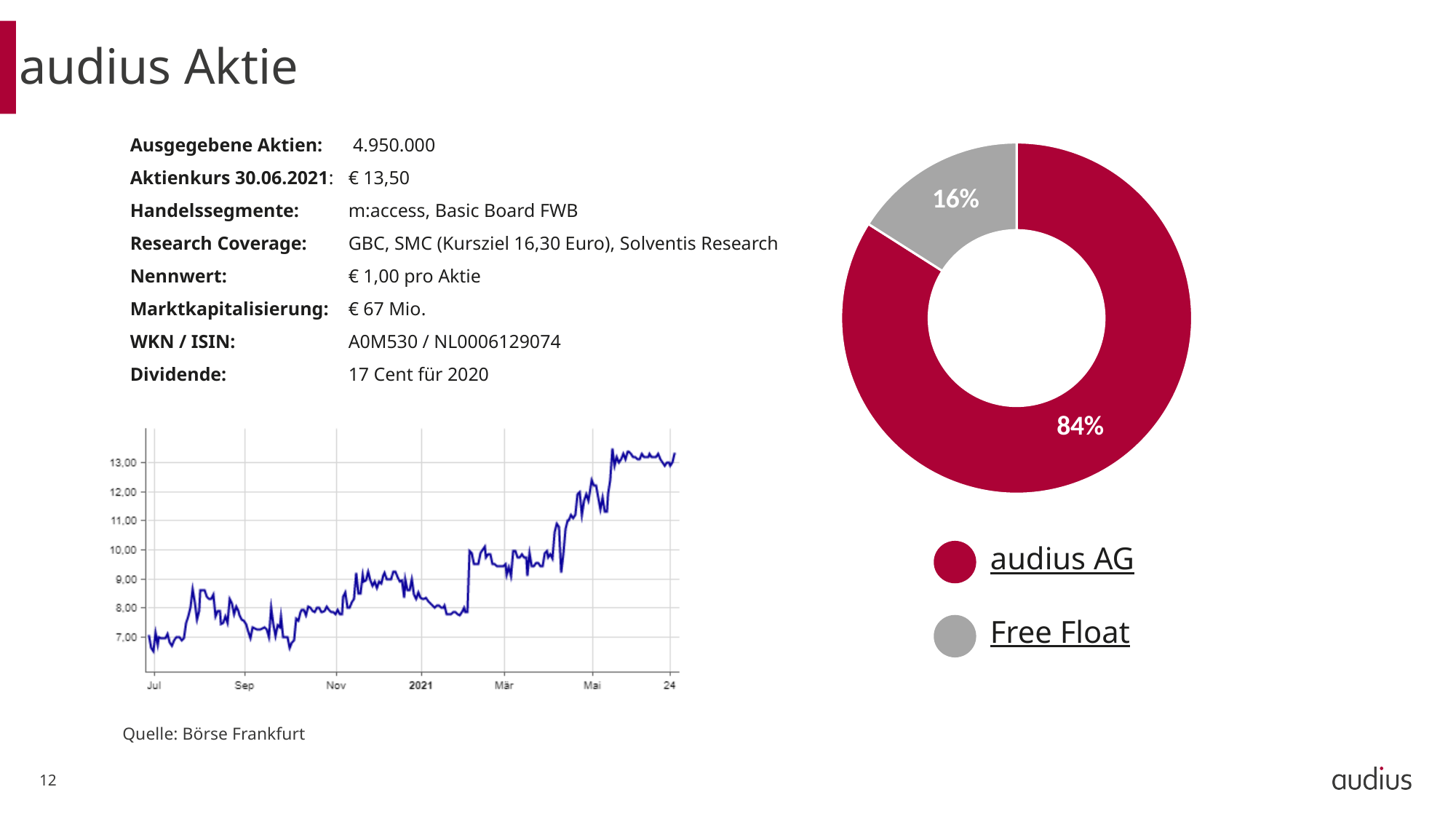
In the donut chart on the right, what share is Free Float? 16% In the donut chart on the right, which category has the largest share? audius AG In the line chart at the bottom left, is the share price at the start of the period (Jul) greater or less than 8,00? less How many entries does the legend of the donut chart on the right list? 2 In the line chart at the bottom left, does the share price overall rise or fall from Jul to the end of the period? Rise In the donut chart on the right, which category has the smallest share? Free Float In the donut chart on the right, what share does audius AG hold? 84% How many categories does the donut chart on the right show? 2 In the donut chart on the right, by how many percentage points does the audius AG share exceed the Free Float share? 68 percentage points In the donut chart on the right, which colour represents Free Float? Grey What kind of chart is shown on the right of the slide? Donut (pie) chart What kind of chart is shown at the bottom left of the slide? Line chart